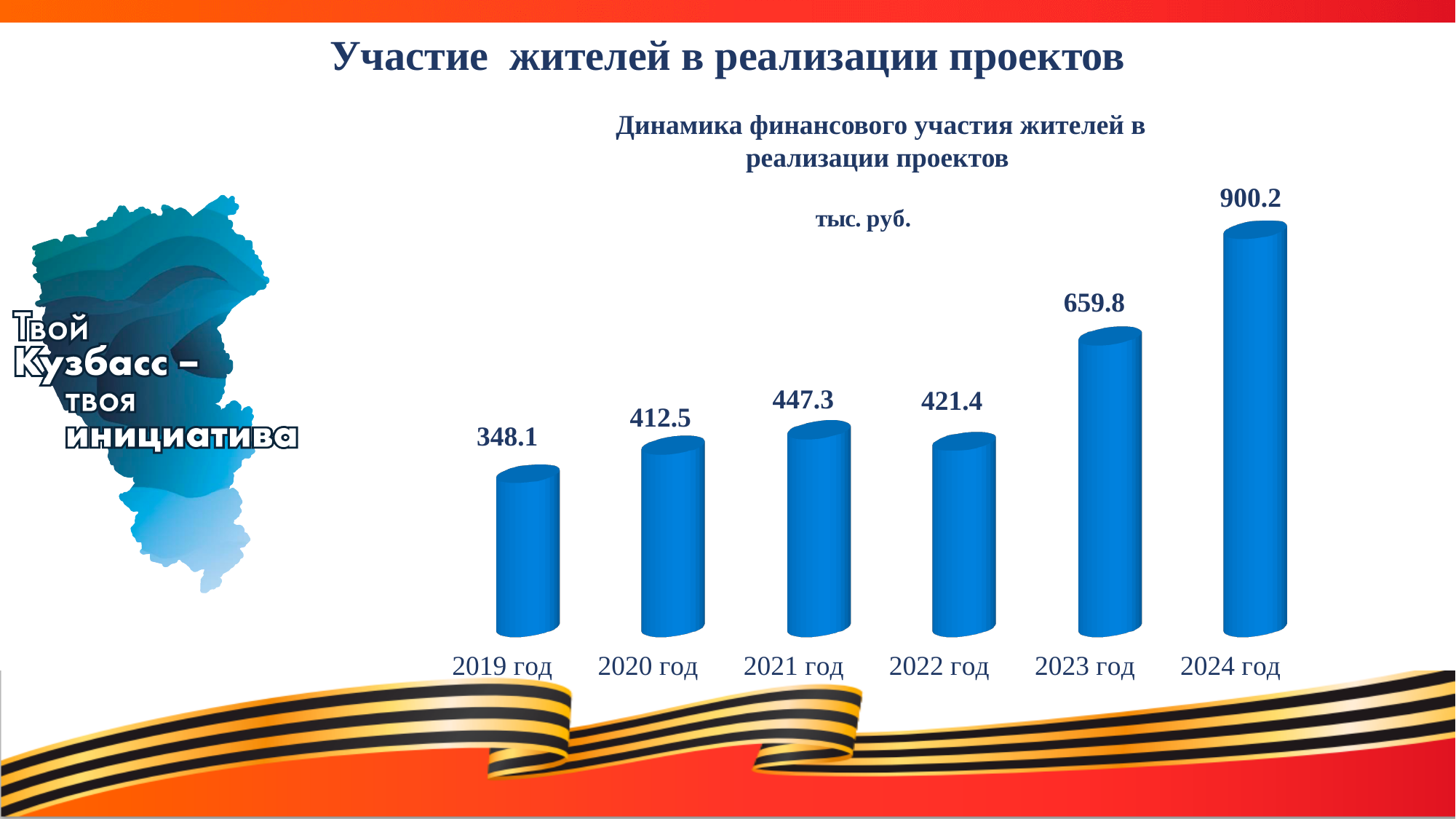
Does the value rise or fall from 2021 год to 2022 год? Fall What unit is shown under the chart title? тыс. руб. What is the difference between the values for 2021 год and 2022 год? 25.9 What is the value for 2024 год? 900.2 How many years are shown on the chart? 6 What is the difference between the values for 2024 год and 2023 год? 240.4 Which year has the highest value? 2024 год Which year has the lowest value? 2019 год What is the value for 2022 год? 421.4 What is the value for 2019 год? 348.1 What kind of chart is shown on the slide? Bar chart Which is larger, the value for 2021 год or the value for 2022 год? 2021 год